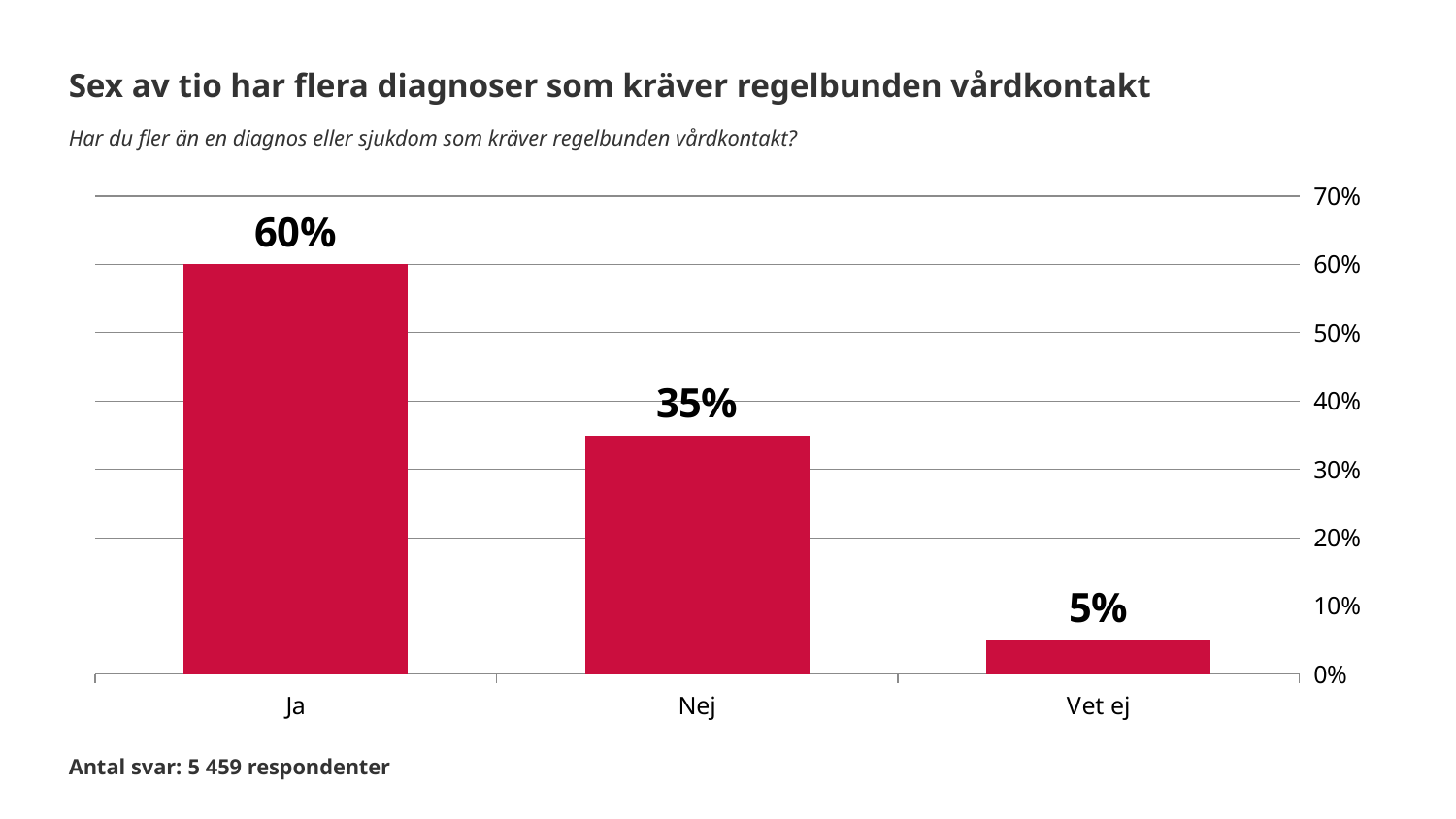
Which category has the highest value? Ja How many categories are shown on the x axis? 3 What is the value for Nej? 35% What is the value for Vet ej? 5% Which is larger, the value for Nej or the value for Vet ej? Nej What is the difference between the values for Ja and Nej? 25% What kind of chart is shown on the slide? bar chart Which category has the lowest value? Vet ej What is the difference between the values for Nej and Vet ej? 30% Is the value for Nej greater or less than 40%? less What is the value for Ja? 60% What is the title of the slide? Sex av tio har flera diagnoser som kräver regelbunden vårdkontakt